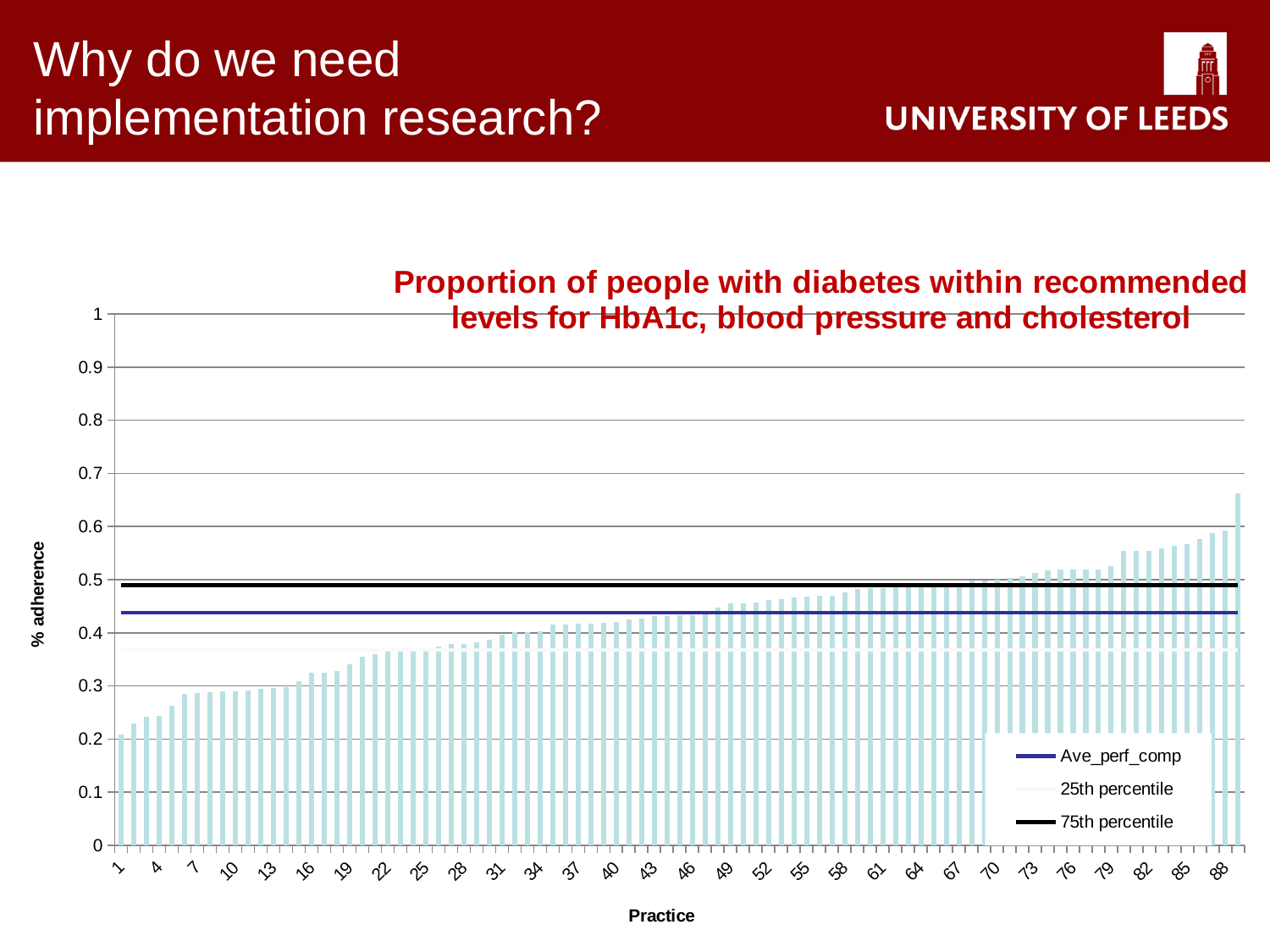
Which line is higher on the chart, the 75th percentile or Ave_perf_comp? 75th percentile Do the bar values rise or fall as the practice number increases along the x axis? rise What is the title of the chart's y axis? % adherence Is the value for practice 1 greater or less than 0.3? less Is the Ave_perf_comp line greater or less than 0.4? greater Is the value for practice 88 greater or less than 0.5? greater How many series does the chart legend list? 3 Which practice has the lowest % adherence? 1 Which is higher, practice 1 or practice 88? practice 88 What kind of chart is shown on the slide? combination bar and line chart